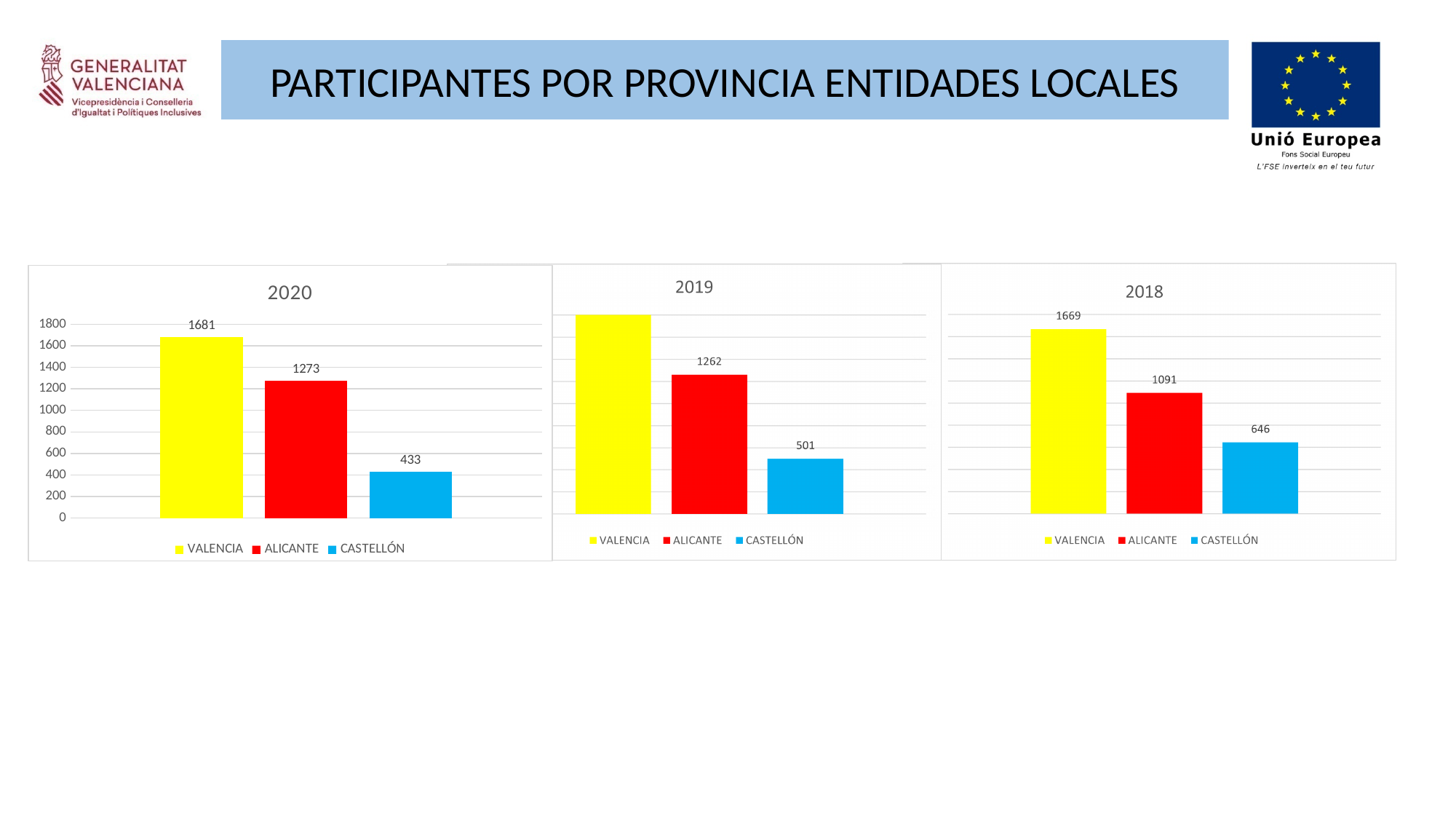
In the 2018 chart, what is the difference between the values for ALICANTE and CASTELLÓN? 445 In the 2019 chart, what is the value for ALICANTE? 1262 What kind of chart is the 2018 chart? bar chart How many series does the legend of the 2019 chart list? 3 In the 2020 chart, what is the value for CASTELLÓN? 433 In the 2018 chart, what is the value for CASTELLÓN? 646 In the 2019 chart, which province has the lowest value? CASTELLÓN In the 2020 chart, what is the value for VALENCIA? 1681 In the 2020 chart, what is the difference between the values for VALENCIA and ALICANTE? 408 In the 2018 chart, which province has the highest value? VALENCIA In the 2020 chart, is the value for ALICANTE greater or less than 1200? greater Which is larger: the CASTELLÓN value in the 2018 chart or the CASTELLÓN value in the 2020 chart? 2018